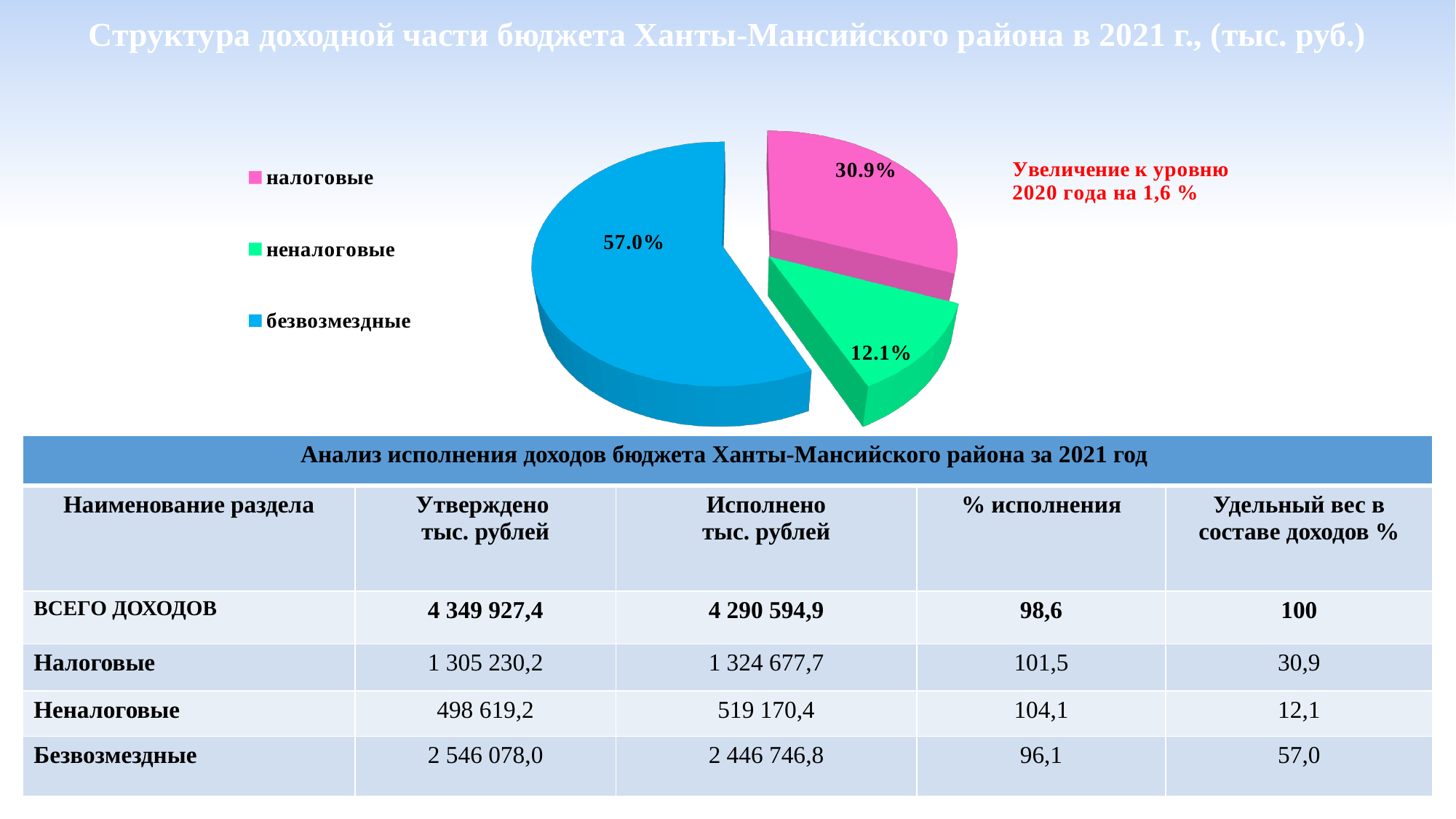
What kind of chart is shown on the slide? pie chart Which slice is larger in the pie chart, налоговые or неналоговые? налоговые What share of the pie does the неналоговые slice represent? 12.1% What colour is the налоговые slice in the pie chart? pink What share of the pie does the налоговые slice represent? 30.9% How many slices does the pie chart have? 3 Which slice of the pie chart is the smallest? неналоговые What colour is the безвозмездные slice in the pie chart? blue How many entries does the pie chart legend list? 3 What is the difference in percentage points between the безвозмездные and налоговые slices? 26.1 What share of the pie does the безвозмездные slice represent? 57.0% Which slice of the pie chart is the largest? безвозмездные